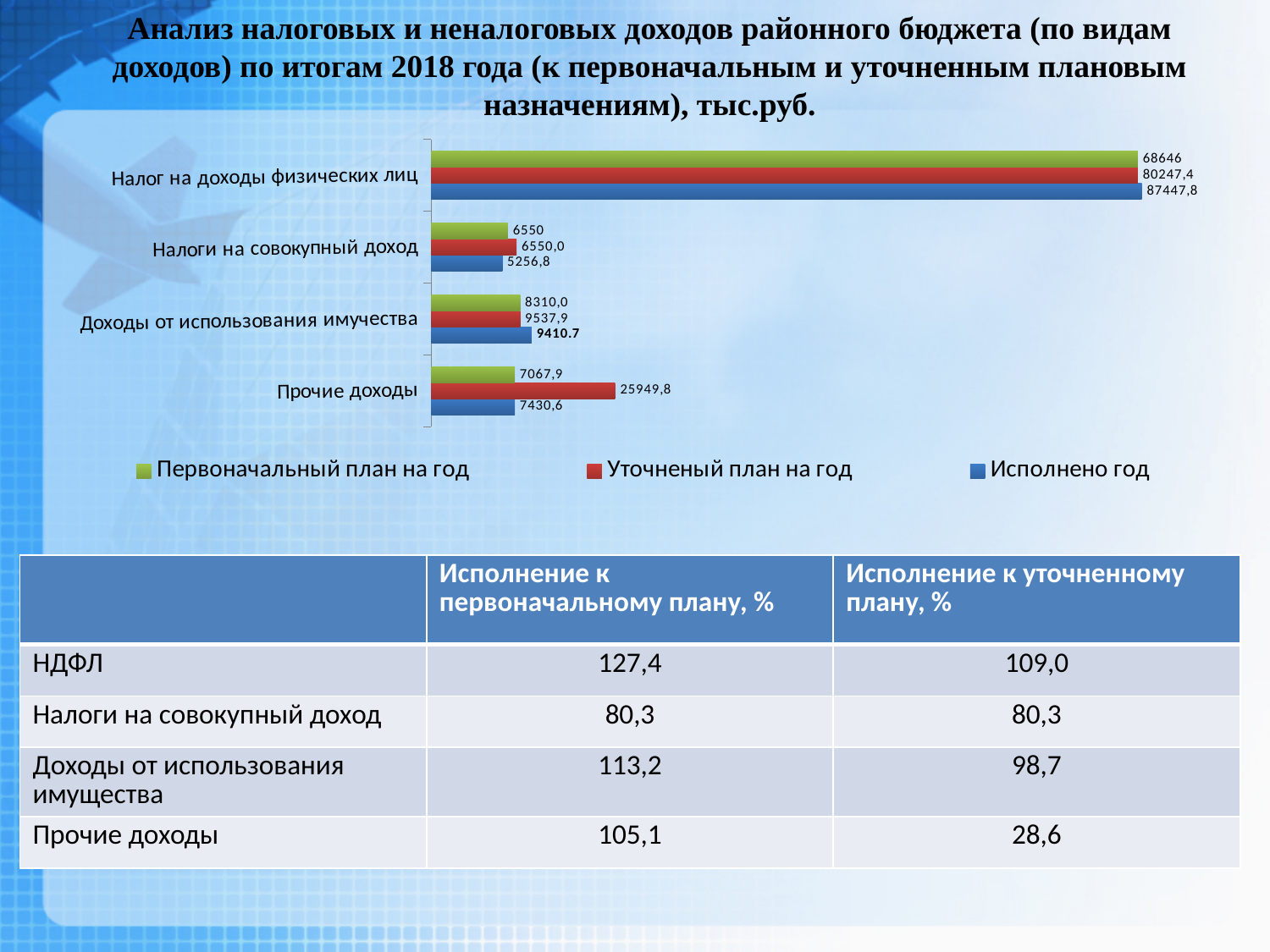
For 'Прочие доходы', which is larger: 'Уточненый план на год' or 'Исполнено год'? Уточненый план на год What kind of chart is shown on the slide? Bar chart What is the difference between 'Исполнено год' and 'Уточненый план на год' for 'Налог на доходы физических лиц'? 7200,4 What is the value of 'Исполнено год' for 'Налог на доходы физических лиц'? 87447,8 What is the value of 'Исполнено год' for 'Налоги на совокупный доход'? 5256,8 What is the value of 'Уточненый план на год' for 'Прочие доходы'? 25949,8 How many series does the chart legend list? 3 What is the value of 'Первоначальный план на год' for 'Доходы от использования имучества'? 8310,0 How many categories are shown on the chart? 4 Which category has the highest value for 'Исполнено год'? Налог на доходы физических лиц Which colour represents the 'Исполнено год' series in the chart? Blue Which category has the lowest value for 'Исполнено год'? Налоги на совокупный доход